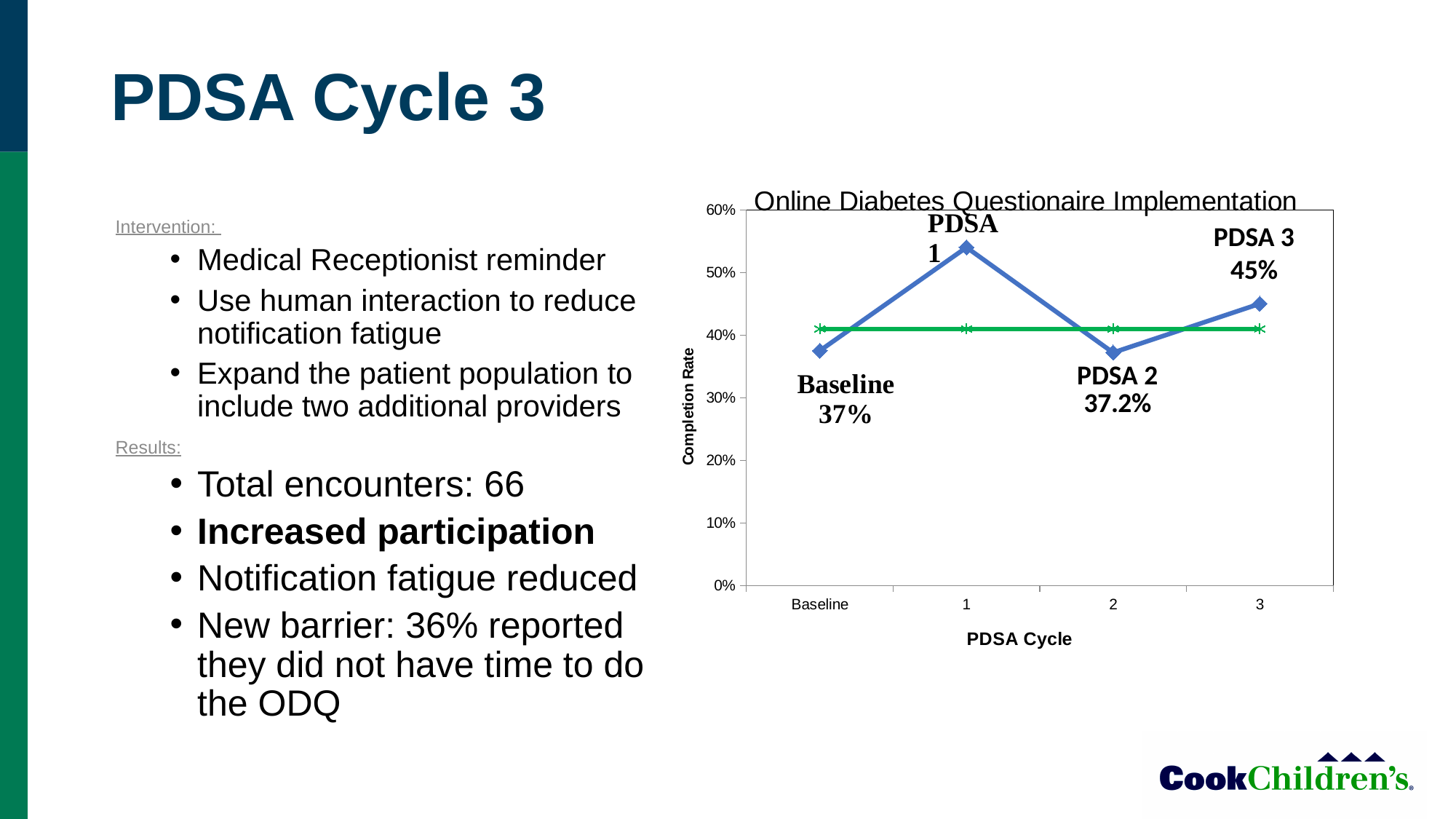
What is the difference between the PDSA 3 and PDSA 2 completion rates? 7.8 percentage points Is the completion rate for PDSA 1 greater or less than 50%? greater Which has a higher completion rate, Baseline or PDSA 3? PDSA 3 Does the completion rate rise or fall from PDSA 2 to PDSA 3? Rise What is the completion rate for PDSA 3? 45% How many points are plotted on the blue completion rate line? 4 What kind of chart is shown on the slide? Line chart What is the title of the chart? Online Diabetes Questionaire Implementation Which PDSA cycle has the highest completion rate? PDSA 1 What is the completion rate for PDSA 2? 37.2% By how many percentage points does the PDSA 3 completion rate exceed the Baseline completion rate? 8 percentage points What is the completion rate at Baseline? 37%